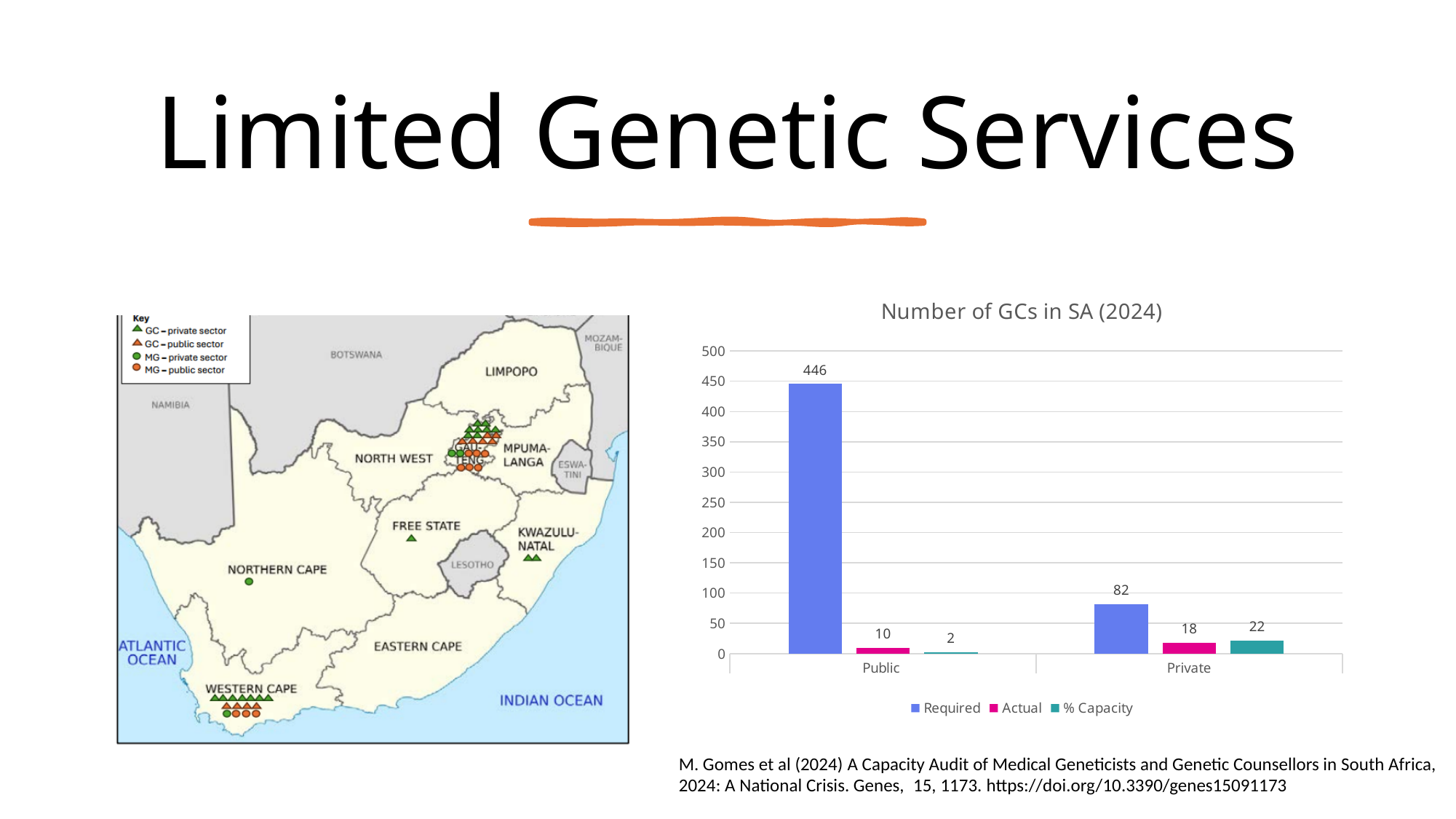
What is the Actual value for Private in the 'Number of GCs in SA (2024)' chart? 18 What type of chart is 'Number of GCs in SA (2024)'? Bar chart What is the Required value for Private in the 'Number of GCs in SA (2024)' chart? 82 What is the % Capacity value for Public in the 'Number of GCs in SA (2024)' chart? 2 How many series does the legend of the 'Number of GCs in SA (2024)' chart list? 3 Which category has the lowest Actual value in the 'Number of GCs in SA (2024)' chart? Public In the 'Number of GCs in SA (2024)' chart, is the Actual value for Private larger or the % Capacity value for Private? % Capacity How many categories are shown on the x axis of the 'Number of GCs in SA (2024)' chart? 2 What is the Required value for Public in the 'Number of GCs in SA (2024)' chart? 446 What is the difference between the Required and Actual values for Public in the 'Number of GCs in SA (2024)' chart? 436 What is the difference between the Required values for Public and Private in the 'Number of GCs in SA (2024)' chart? 364 Which category has the highest Required value in the 'Number of GCs in SA (2024)' chart? Public